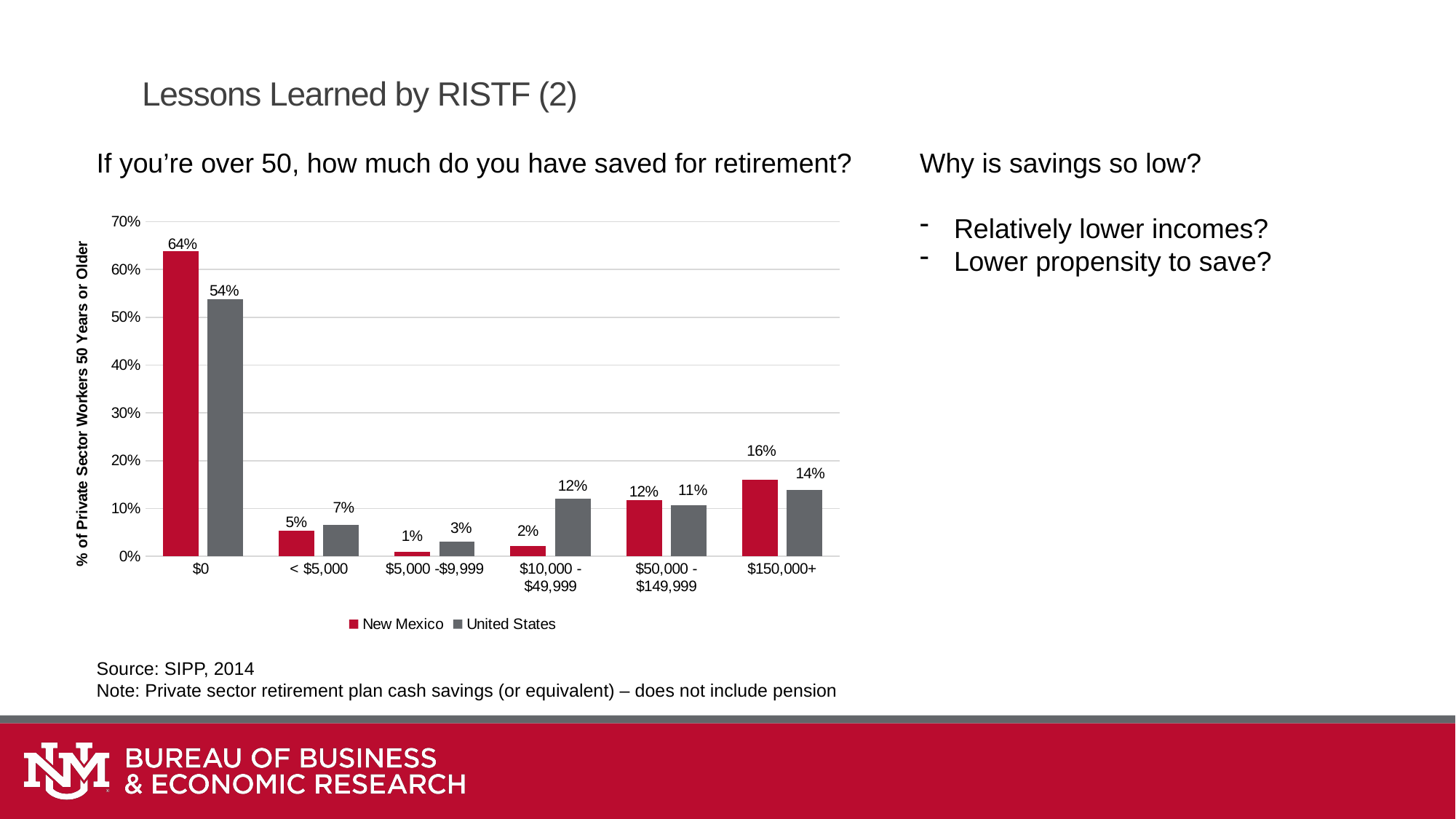
What is the New Mexico value for the $5,000 - $9,999 category? 1% Which savings category has the lowest value for the United States? $5,000 - $9,999 What percentage of New Mexico private sector workers 50 years or older have $0 saved for retirement? 64% What kind of chart is shown on the slide? Bar chart For the < $5,000 category, which is larger: New Mexico or United States? United States What is the difference between the New Mexico and United States values for the $0 category? 10% Which savings category has the highest value for New Mexico? $0 How many series does the legend list? 2 How many savings categories are shown on the x axis? 6 What is the difference between the United States and New Mexico values for the $10,000 - $49,999 category? 10% What is the United States value for the $150,000+ savings category? 14% For the $50,000 - $149,999 category, which is larger: New Mexico or United States? New Mexico